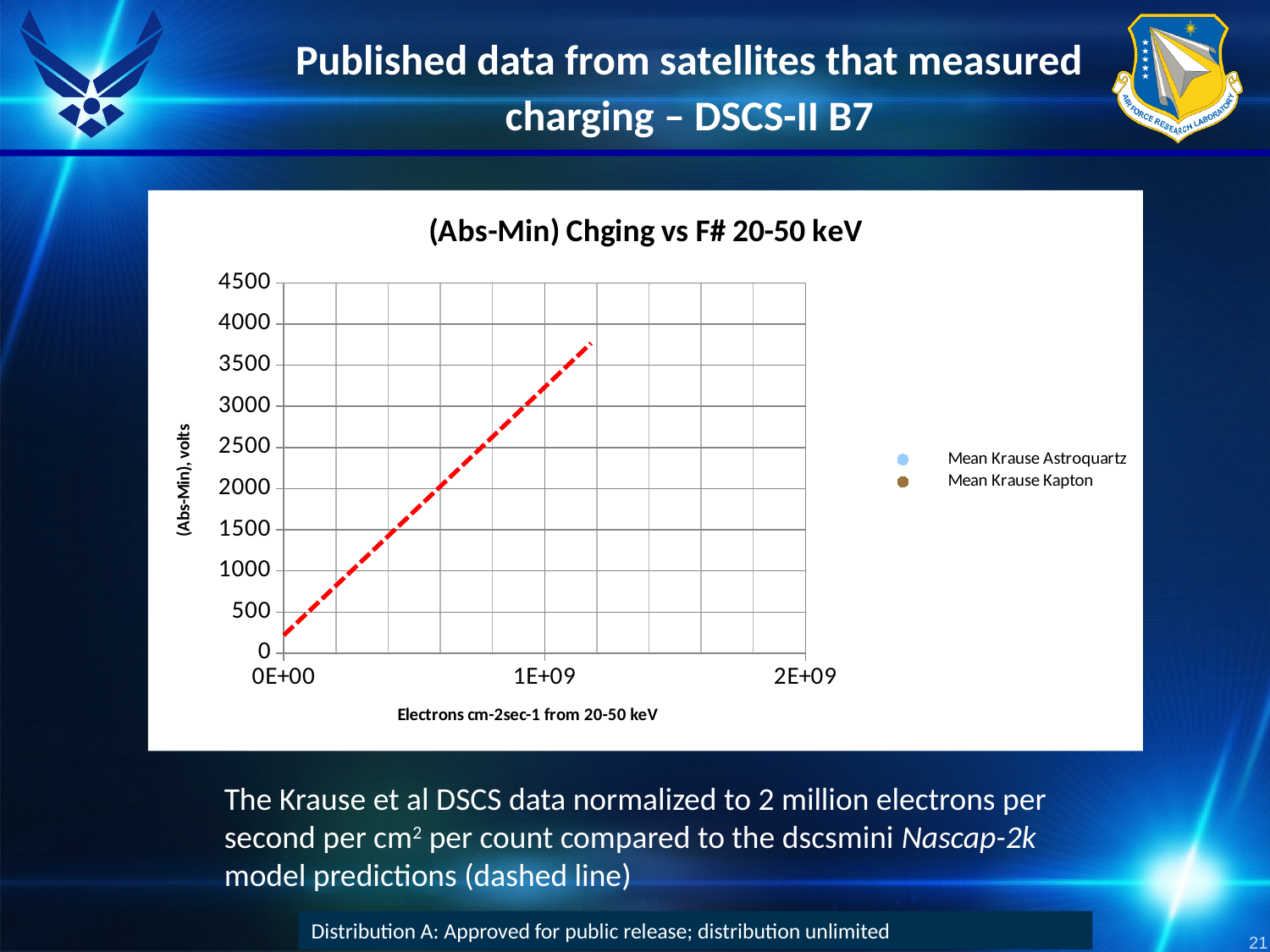
What colour is the dashed model prediction line on the chart? Red What is the title of the chart? (Abs-Min) Chging vs F# 20-50 keV What kind of chart is shown on the slide? Line chart Is the value of the dashed line at 1E+09 electrons greater or less than 2500 volts? greater What are the two series named in the chart legend? Mean Krause Astroquartz and Mean Krause Kapton Is the maximum value reached by the dashed line greater or less than 4000 volts? less How many series does the chart legend list? 2 Does the red dashed line rise or fall as the electron flux on the x axis increases? Rises Is the value of the dashed line at 0E+00 electrons greater or less than 500 volts? less